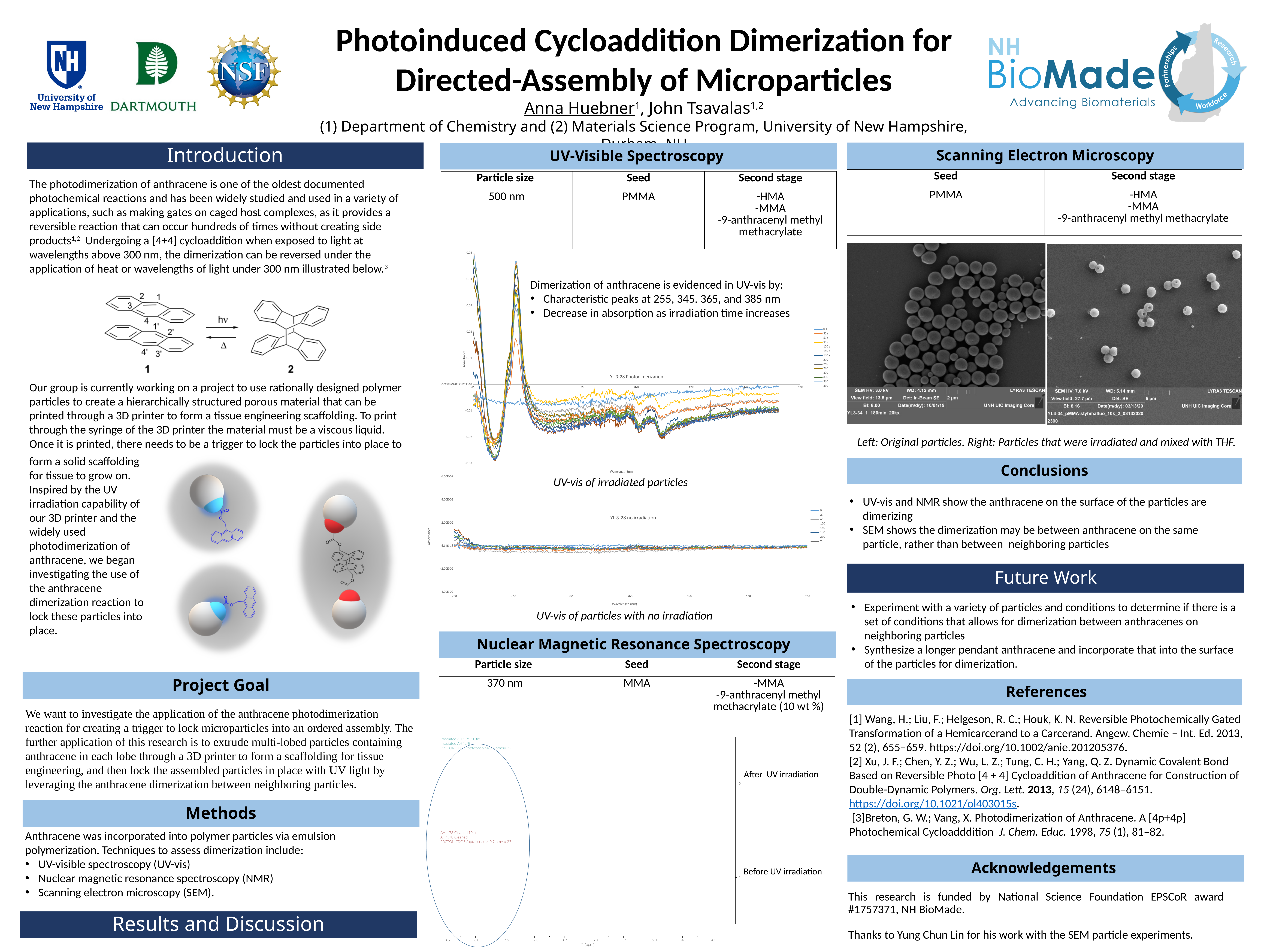
What is the highest y-axis tick shown on the 'UV-vis of particles with no irradiation' chart? 6.00E-02 What is the highest wavelength tick shown on the x axis of the 'UV-vis of particles with no irradiation' chart? 520 What is the lowest wavelength tick shown on the x axis of the 'UV-vis of particles with no irradiation' chart? 220 In the 'UV-vis of irradiated particles' chart, what is the label of the x axis? Wavelength (nm) What is the highest y-axis tick shown on the 'UV-vis of irradiated particles' chart? 0.05 Which of the two UV-vis charts shows a larger spread between its series, the irradiated particles chart or the no irradiation chart? irradiated particles chart What kind of chart is the 'UV-vis of particles with no irradiation' chart? line chart In the 'UV-vis of particles with no irradiation' chart, is the absorbance at 420 nm greater or less than 2.00E-02? less What kind of chart is the 'UV-vis of irradiated particles' chart? line chart In the 'UV-vis of irradiated particles' chart, what is the label of the y axis? Absorbance In the 'UV-vis of irradiated particles' chart, is the peak absorbance near 255 nm for the 0 s series greater or less than 0.03? greater In the 'UV-vis of irradiated particles' chart, does the absorbance at the peaks increase or decrease as irradiation time increases? decrease